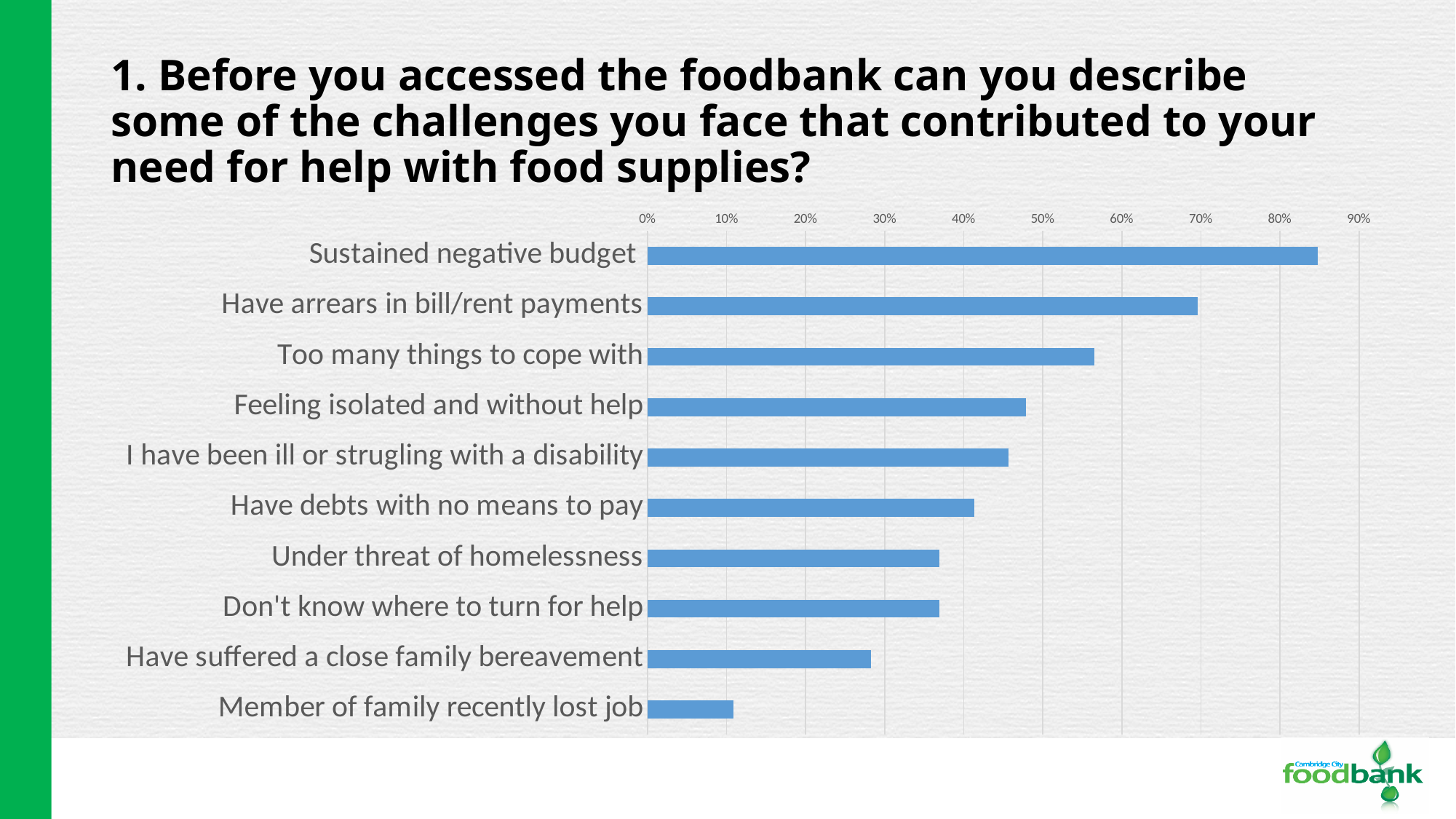
Is the value for Too many things to cope with greater or less than 50%? greater What kind of chart is shown on the slide? bar chart Is the value for Under threat of homelessness greater or less than 40%? less Which category has the highest value? Sustained negative budget Which is larger: the value for Sustained negative budget or the value for Have arrears in bill/rent payments? Sustained negative budget Is the value for Have arrears in bill/rent payments greater or less than 60%? greater How many categories are plotted in the chart? 10 Which is larger: the value for Have suffered a close family bereavement or the value for Member of family recently lost job? Have suffered a close family bereavement Which category has the lowest value? Member of family recently lost job What is the highest percentage tick shown on the horizontal axis? 90%